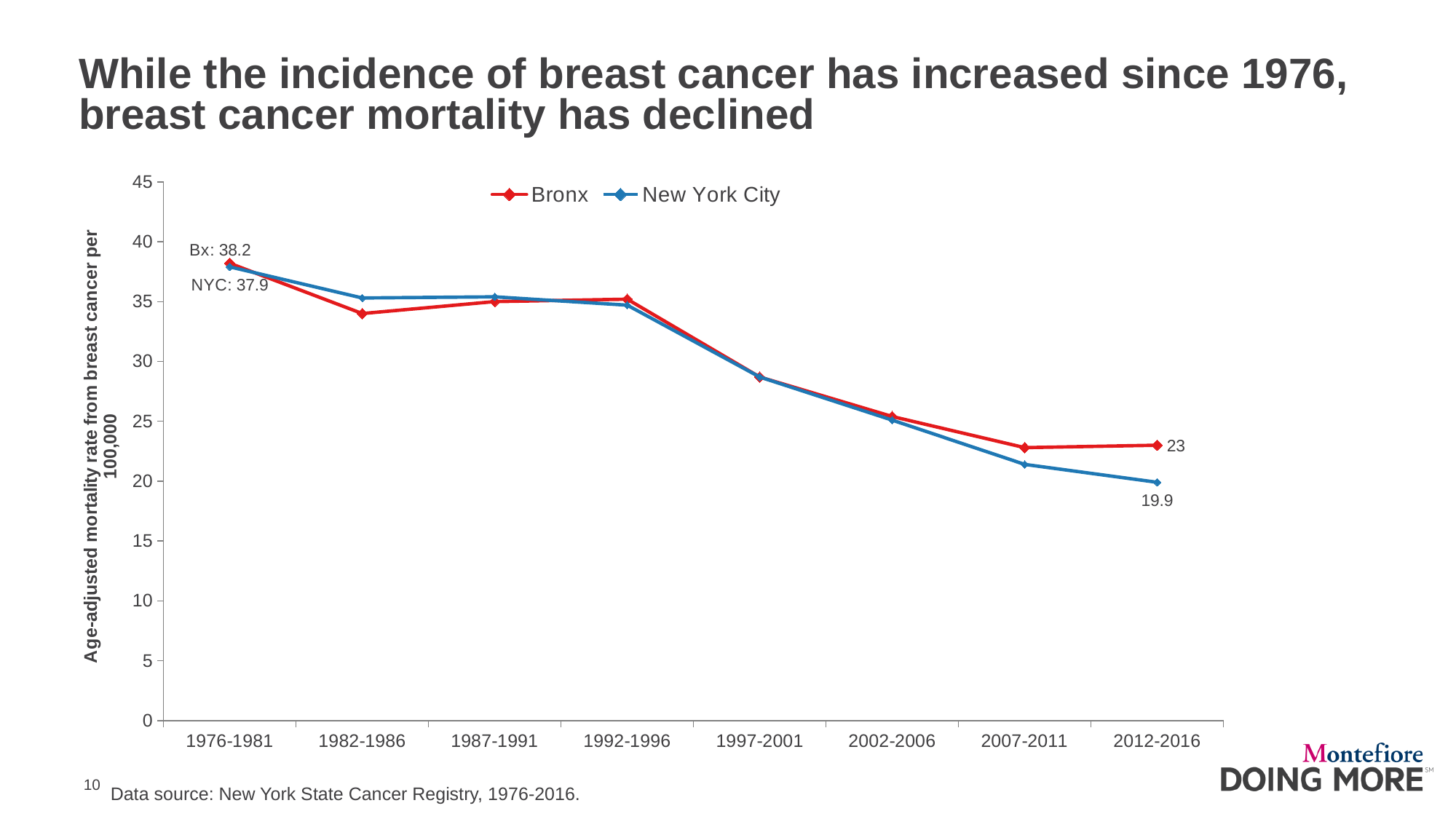
Is the New York City value for 2007-2011 greater or less than 25? less Do the mortality rates rise or fall across the periods from 1976-1981 to 2012-2016? fall What type of chart is shown on the slide? line chart Which series has the higher value in 2012-2016, Bronx or New York City? Bronx What is the difference between the Bronx and New York City mortality rates in 2012-2016? 3.1 What is the New York City mortality rate for 1976-1981? 37.9 By how much did the Bronx mortality rate fall from 1976-1981 to 2012-2016? 15.2 How many series does the legend list? 2 What is the Bronx mortality rate for 1976-1981? 38.2 What is the New York City mortality rate for 2012-2016? 19.9 How many time periods are shown on the x axis? 8 What is the Bronx mortality rate for 2012-2016? 23